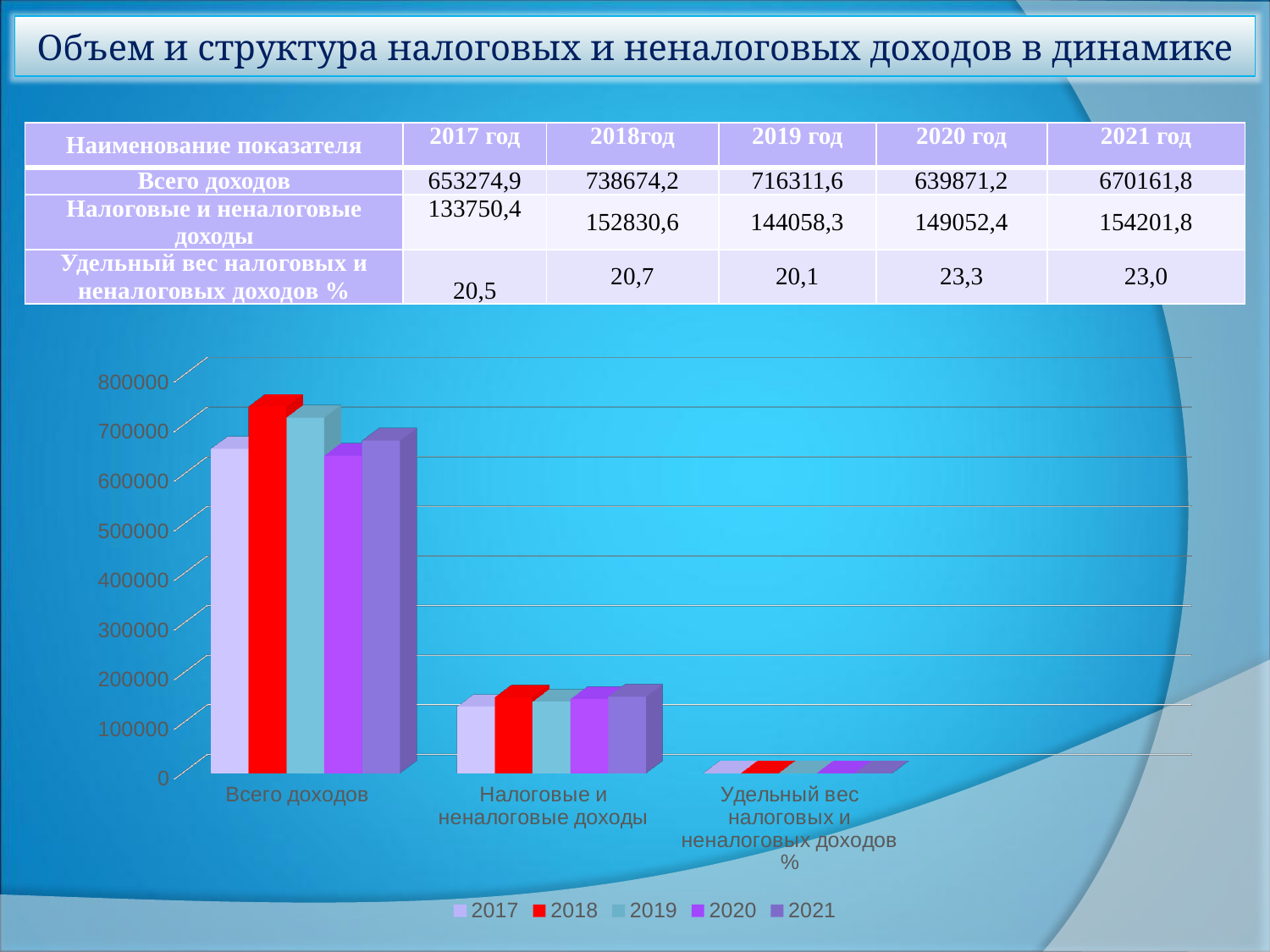
What colour represents the 2018 series in the chart? red What is the difference between "Всего доходов" in 2018 and in 2017? 85399,3 Which year has the lowest bar for "Всего доходов"? 2020 How many categories are shown on the x axis of the chart? 3 Which is larger for "Налоговые и неналоговые доходы": the 2019 value or the 2020 value? 2020 What is the value of "Удельный вес налоговых и неналоговых доходов %" for 2020? 23,3 Which year has the highest bar for "Всего доходов"? 2018 Is the value for "Налоговые и неналоговые доходы" in 2017 greater or less than 200000? less Is the value for "Всего доходов" in 2018 greater or less than 700000? greater What is the value of "Налоговые и неналоговые доходы" for 2021? 154201,8 How many series does the chart legend list? 5 What kind of chart is shown on the slide? bar chart